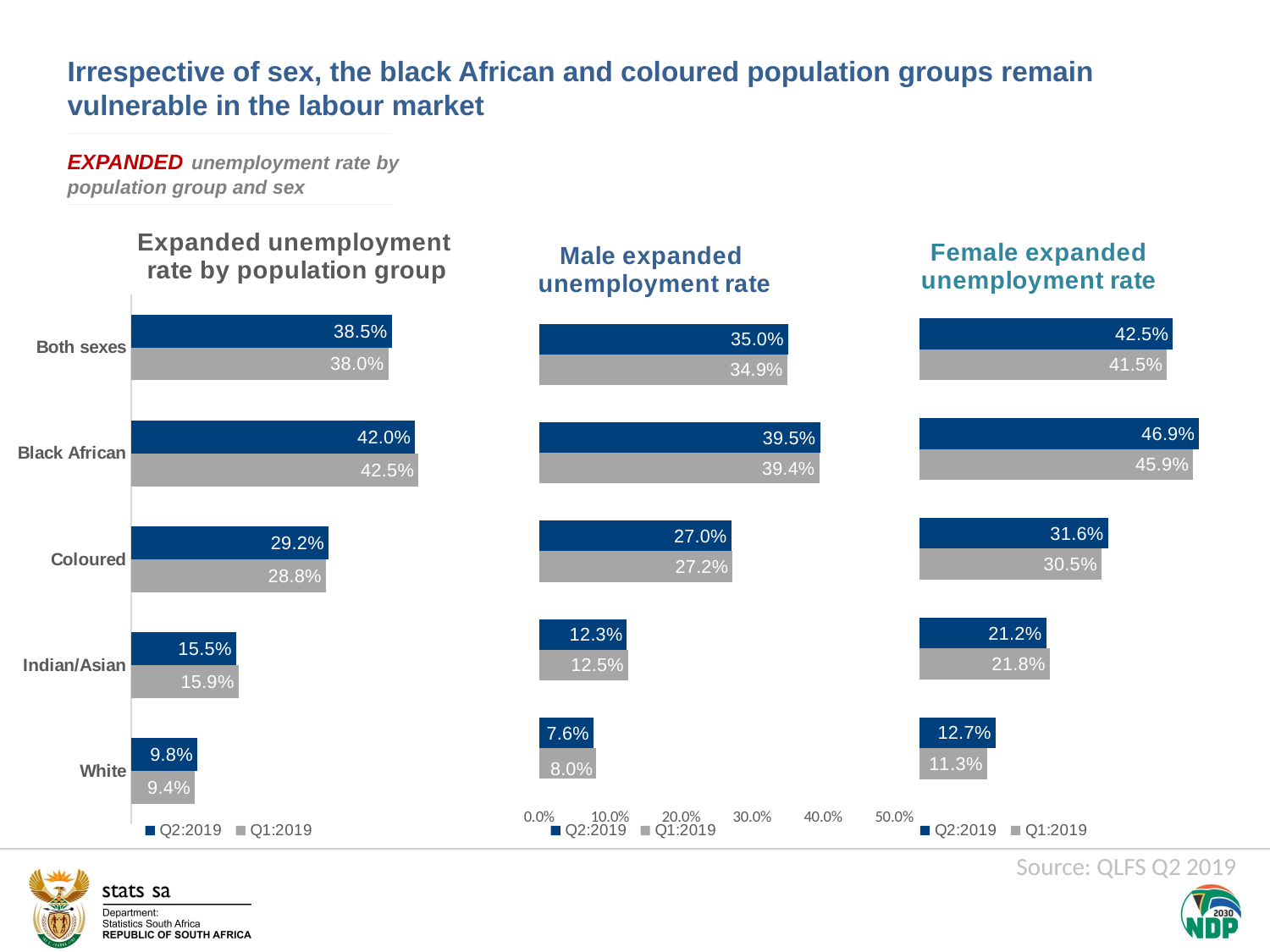
In the 'Expanded unemployment rate by population group' chart, what is the Q1:2019 value for White? 9.4% In the 'Female expanded unemployment rate' chart, what is the Q1:2019 value in the Both sexes row? 41.5% In the 'Expanded unemployment rate by population group' chart, which population group has the highest Q2:2019 value? Black African How many population group categories are shown in the 'Expanded unemployment rate by population group' chart? 5 Which series does the blue colour represent in the legend of the 'Expanded unemployment rate by population group' chart? Q2:2019 In the 'Expanded unemployment rate by population group' chart, which population group has the lowest Q1:2019 value? White In the 'Expanded unemployment rate by population group' chart, what is the Q2:2019 value for Black African? 42.0% What type of chart is the 'Female expanded unemployment rate' chart? bar chart In the 'Male expanded unemployment rate' chart, what is the Q2:2019 value in the Black African row? 39.5% In the 'Expanded unemployment rate by population group' chart, what is the difference between the Q2:2019 and Q1:2019 values for Coloured? 0.4% How many series does the legend of the 'Male expanded unemployment rate' chart list? 2 In the 'Expanded unemployment rate by population group' chart, is the Q2:2019 value for Indian/Asian larger or smaller than the Q1:2019 value? smaller